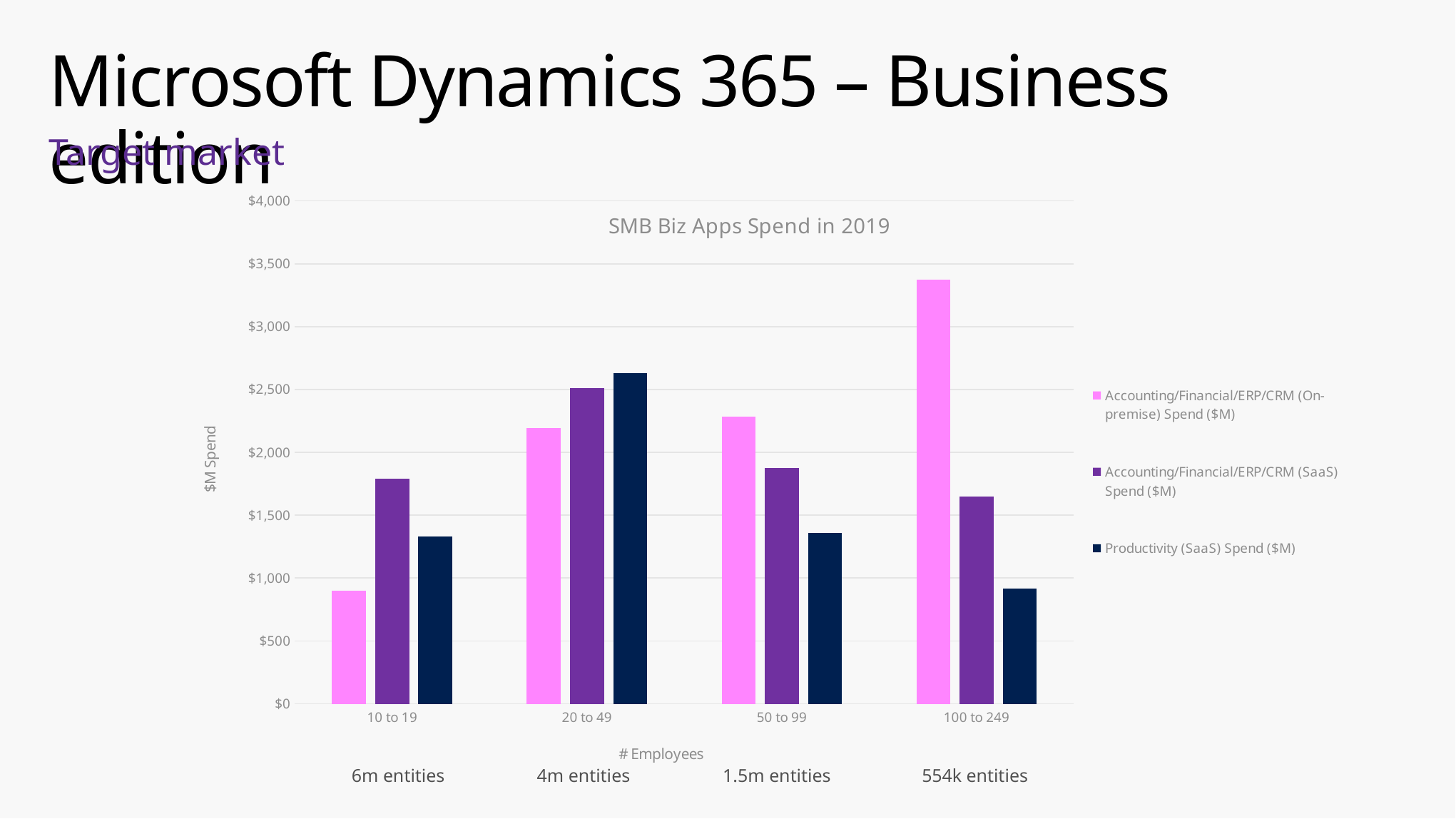
How many series does the legend list? 3 Is the Accounting/Financial/ERP/CRM (On-premise) Spend for 10 to 19 employees greater or less than $1,000? less Is the Accounting/Financial/ERP/CRM (SaaS) Spend for 10 to 19 employees greater or less than $1,500? greater Is the Accounting/Financial/ERP/CRM (On-premise) Spend for 100 to 249 employees greater or less than $3,000? greater How many employee-size categories are shown on the x axis? 4 What is the title of the chart? SMB Biz Apps Spend in 2019 What is the label on the vertical axis? $M Spend What kind of chart is shown on the slide? bar chart Which employee band has the highest Accounting/Financial/ERP/CRM (On-premise) Spend? 100 to 249 For the 50 to 99 employee band, which is larger: the On-premise spend or the SaaS spend for Accounting/Financial/ERP/CRM? On-premise Which employee band has the lowest Productivity (SaaS) Spend? 100 to 249 Does the Accounting/Financial/ERP/CRM (On-premise) Spend rise or fall as the employee bands increase from 10 to 19 to 100 to 249? rise